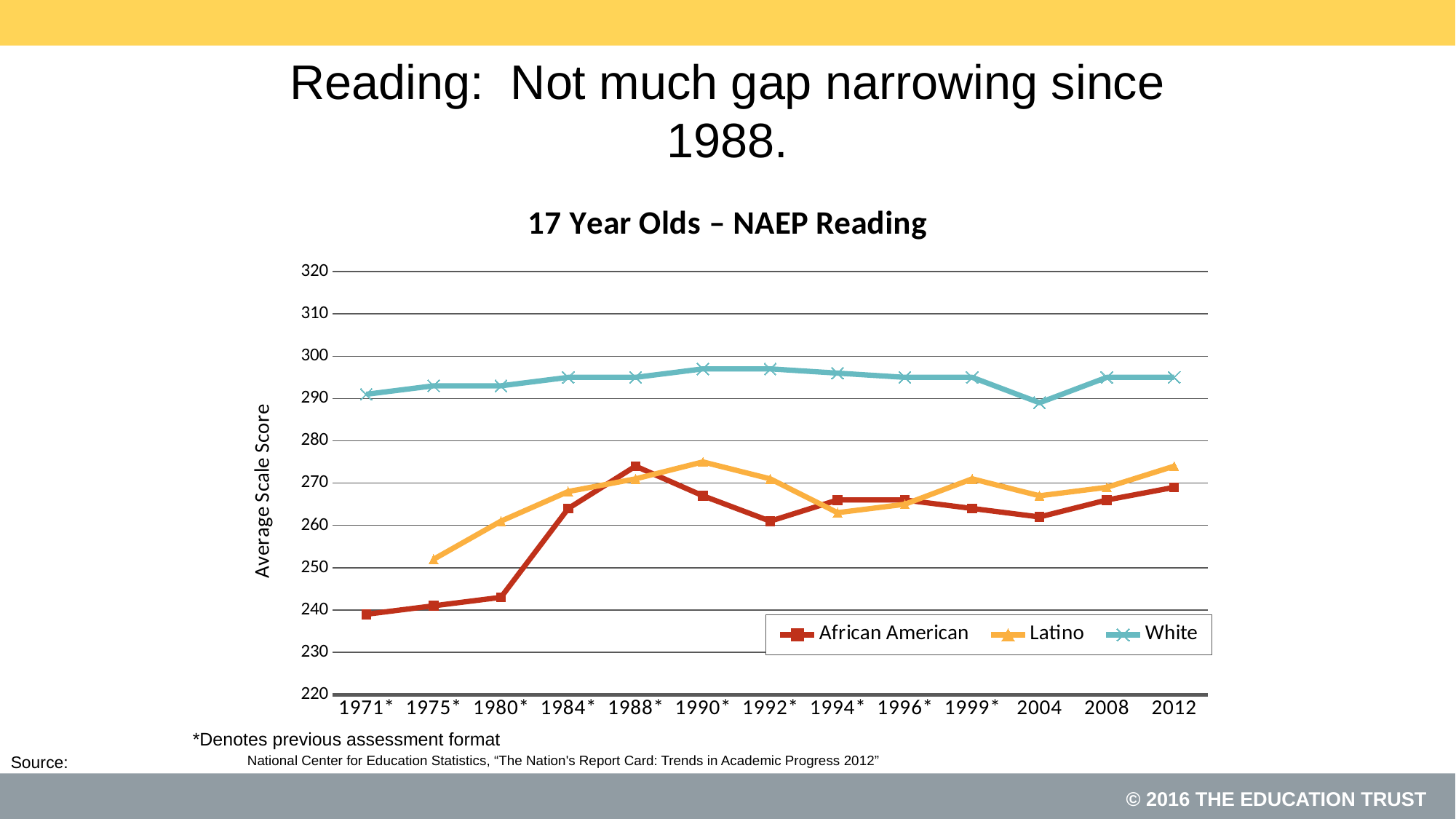
In which year does the African American series reach its highest value? 1988* How many assessment years are plotted along the x axis? 13 How many series does the legend list? 3 Is the value for White in 1990* greater or less than 290? greater Which series has the highest values throughout the chart? White In which year is the White series at its lowest value? 2004 In which year is the African American series at its lowest value? 1971* What kind of chart is shown on the slide? line chart In 1990*, which is larger, the Latino value or the African American value? Latino Is the value for African American in 1971* greater or less than 250? less Does the African American series rise or fall from 1971* to 1988*? rise Is the value for Latino in 1975* greater or less than 260? less